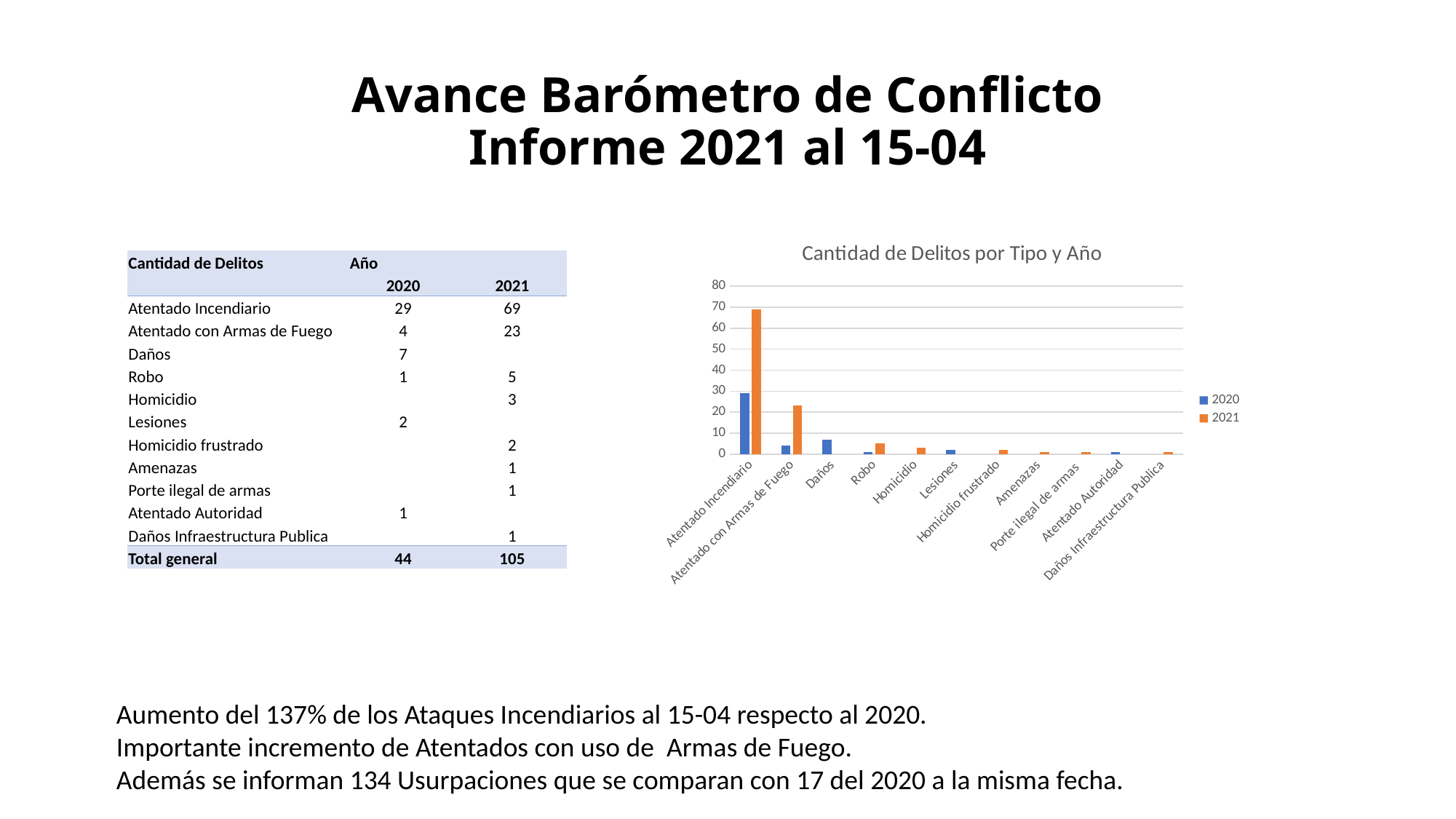
What is the title of the chart? Cantidad de Delitos por Tipo y Año How many crime types (categories) are shown on the x axis of the chart? 11 What is the difference between the 2021 and 2020 values for Atentado Incendiario? 40 How many series does the legend of the chart list? 2 What is the 2021 value for Atentado Incendiario? 69 What is the 2020 value for Atentado Incendiario? 29 Which category has the highest 2021 bar in the chart? Atentado Incendiario Is the 2021 value for Atentado con Armas de Fuego greater or less than 30? less For Atentado Incendiario, which year has the larger value, 2020 or 2021? 2021 Which is larger: the 2020 value for Daños or the 2021 value for Robo? 2020 value for Daños Is the 2021 value for Atentado Incendiario greater or less than 60? greater What kind of chart is shown on the slide? Bar chart